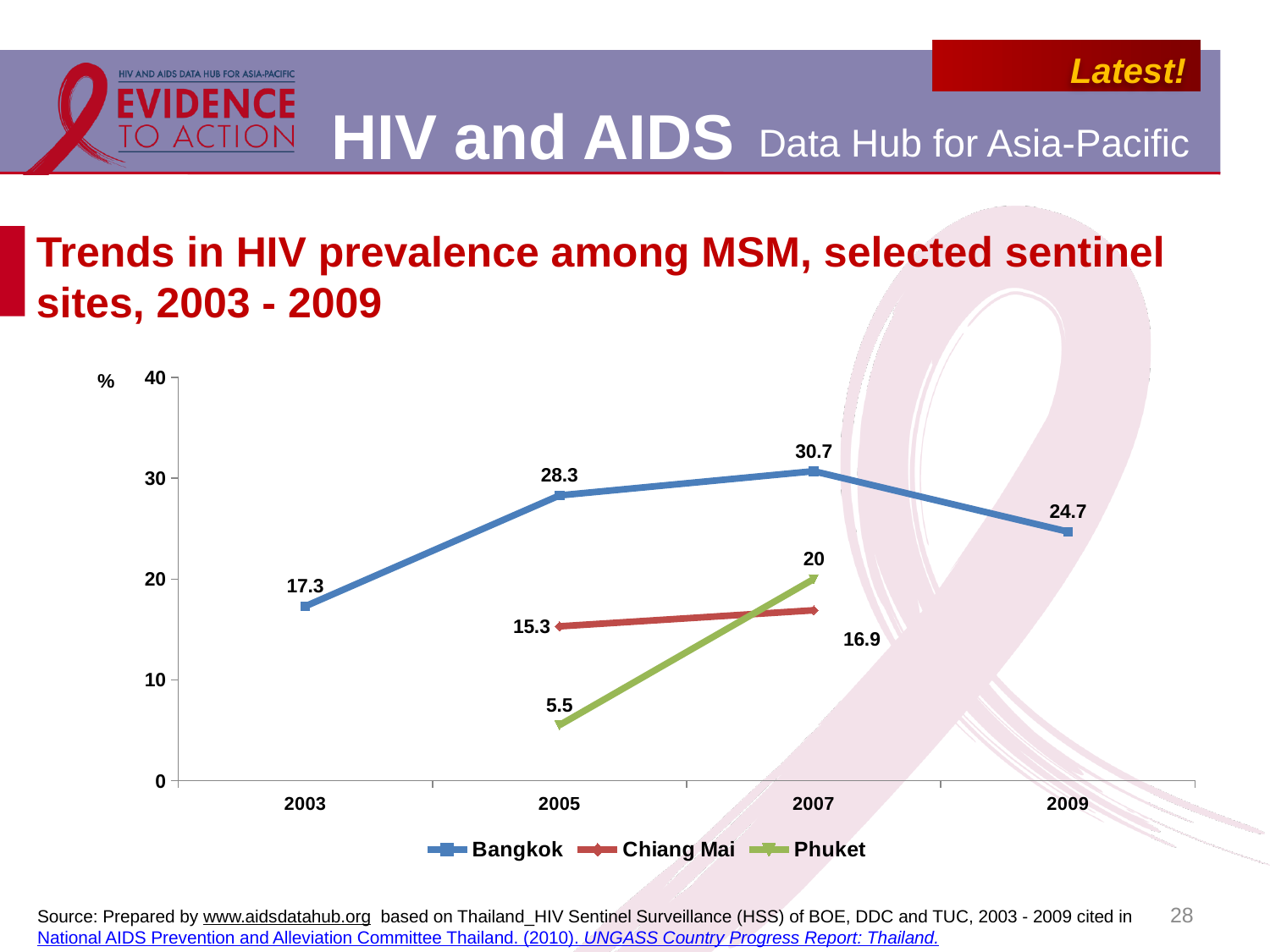
How many series does the legend list? 3 Is the Bangkok value for 2009 greater or less than 20? greater Did HIV prevalence among MSM in Chiang Mai rise or fall from 2005 to 2007? Rise What was the HIV prevalence among MSM in Phuket in 2005? 5.5 How many years are shown on the x axis? 4 By how much did HIV prevalence among MSM in Phuket increase from 2005 to 2007? 14.5 In which year did Bangkok record its highest HIV prevalence among MSM? 2007 What was the HIV prevalence among MSM in Bangkok in 2007? 30.7 What was the HIV prevalence among MSM in Chiang Mai in 2007? 16.9 What kind of chart is shown on the slide? Line chart Which site had the higher HIV prevalence among MSM in 2007, Chiang Mai or Phuket? Phuket In which year did Bangkok record its lowest HIV prevalence among MSM? 2003